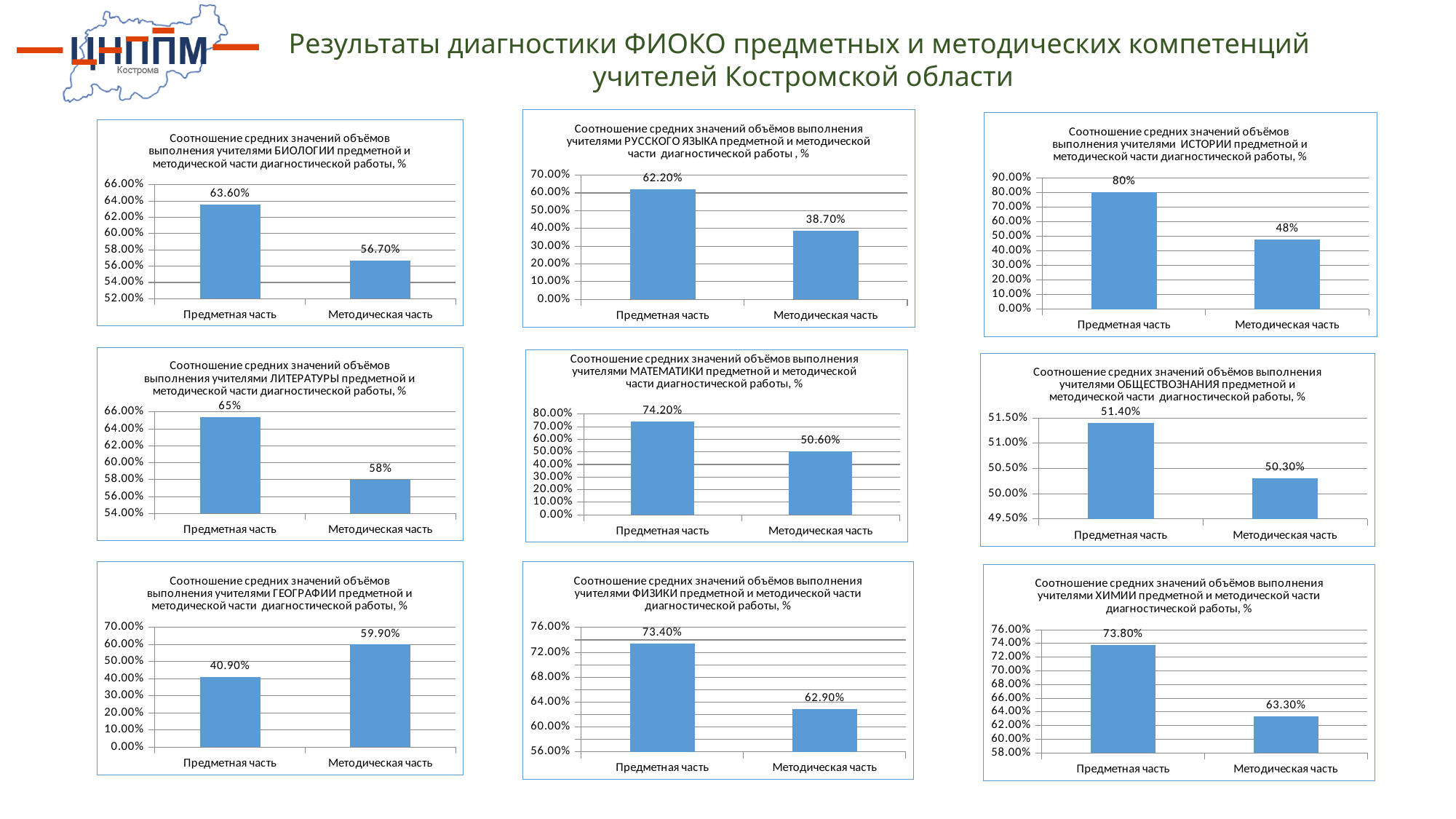
In the chart for teachers of ХИМИИ (chemistry), what is the difference between Предметная часть and Методическая часть? 10.50% In the chart for teachers of РУССКОГО ЯЗЫКА (Russian language), what is the value for Методическая часть? 38.70% In the chart for teachers of ФИЗИКИ (physics), is the value for Предметная часть larger or smaller than the value for Методическая часть? larger In the chart for teachers of ГЕОГРАФИИ (geography), which category has the highest value? Методическая часть In the chart for teachers of БИОЛОГИИ (biology), what is the value for Предметная часть? 63.60% In the chart for teachers of ИСТОРИИ (history), what is the difference between Предметная часть and Методическая часть? 32% How many charts are shown on the slide? 9 In the chart for teachers of РУССКОГО ЯЗЫКА (Russian language), how many categories are shown on the x axis? 2 In the chart for teachers of МАТЕМАТИКИ (mathematics), what is the value for Предметная часть? 74.20% In the chart for teachers of ОБЩЕСТВОЗНАНИЯ (social studies), what is the value for Методическая часть? 50.30% In the chart for teachers of ЛИТЕРАТУРЫ (literature), which category has the lowest value? Методическая часть What type of chart is used for teachers of ГЕОГРАФИИ (geography)? bar chart